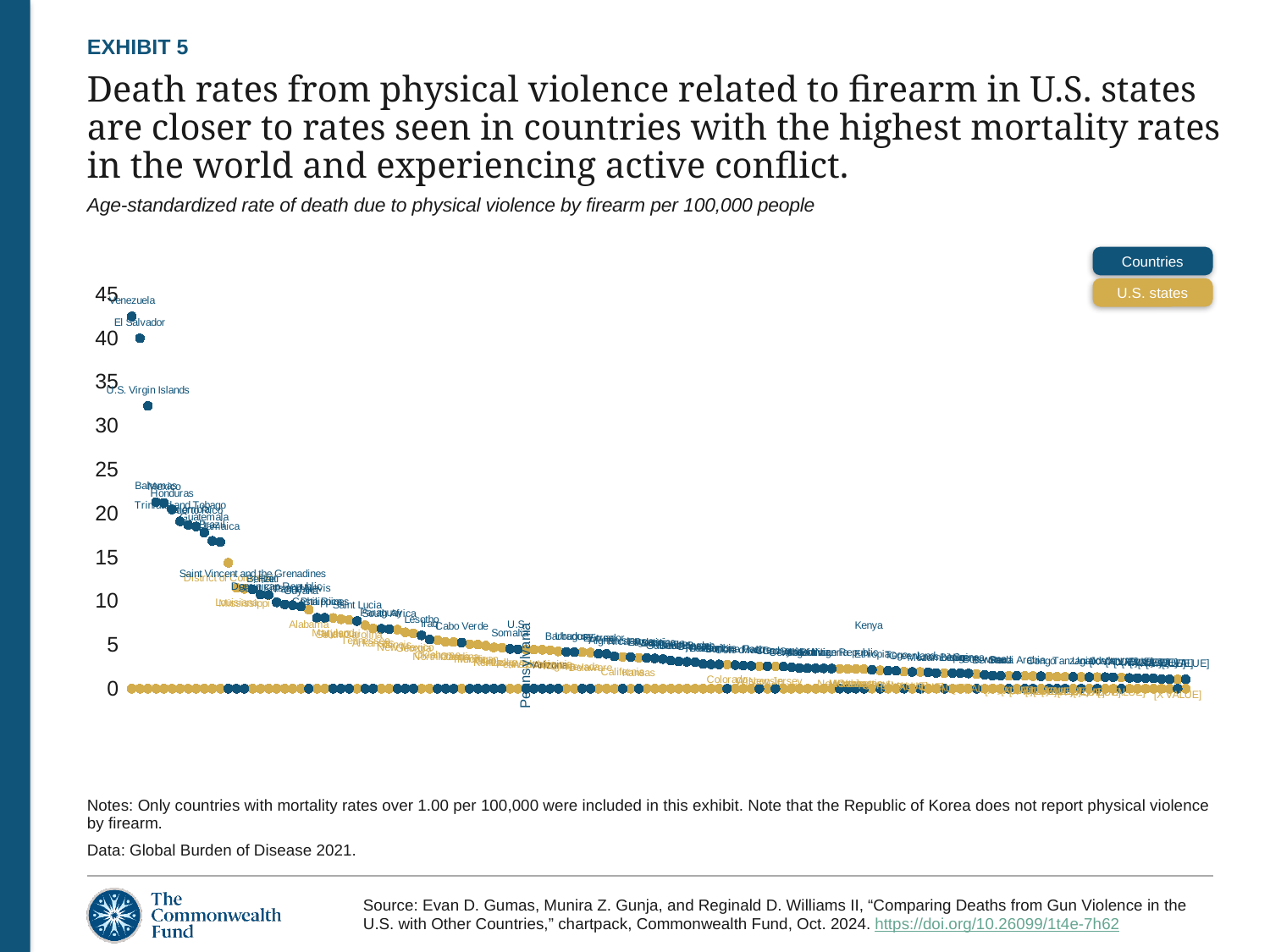
What are the two series named in the legend? Countries and U.S. states How many series does the legend list? 2 Which has the higher value, Venezuela or El Salvador? Venezuela Do the plotted values rise or fall moving from left to right along the x axis? Fall Is the value for U.S. Virgin Islands greater or less than 35? less What kind of chart is shown on the slide? Scatter chart Is the value for U.S. Virgin Islands greater or less than 30? greater Which country has the highest death rate in the chart? Venezuela Is the value for Saint Vincent and the Grenadines greater or less than 15? less Which colour represents U.S. states in the chart? Gold